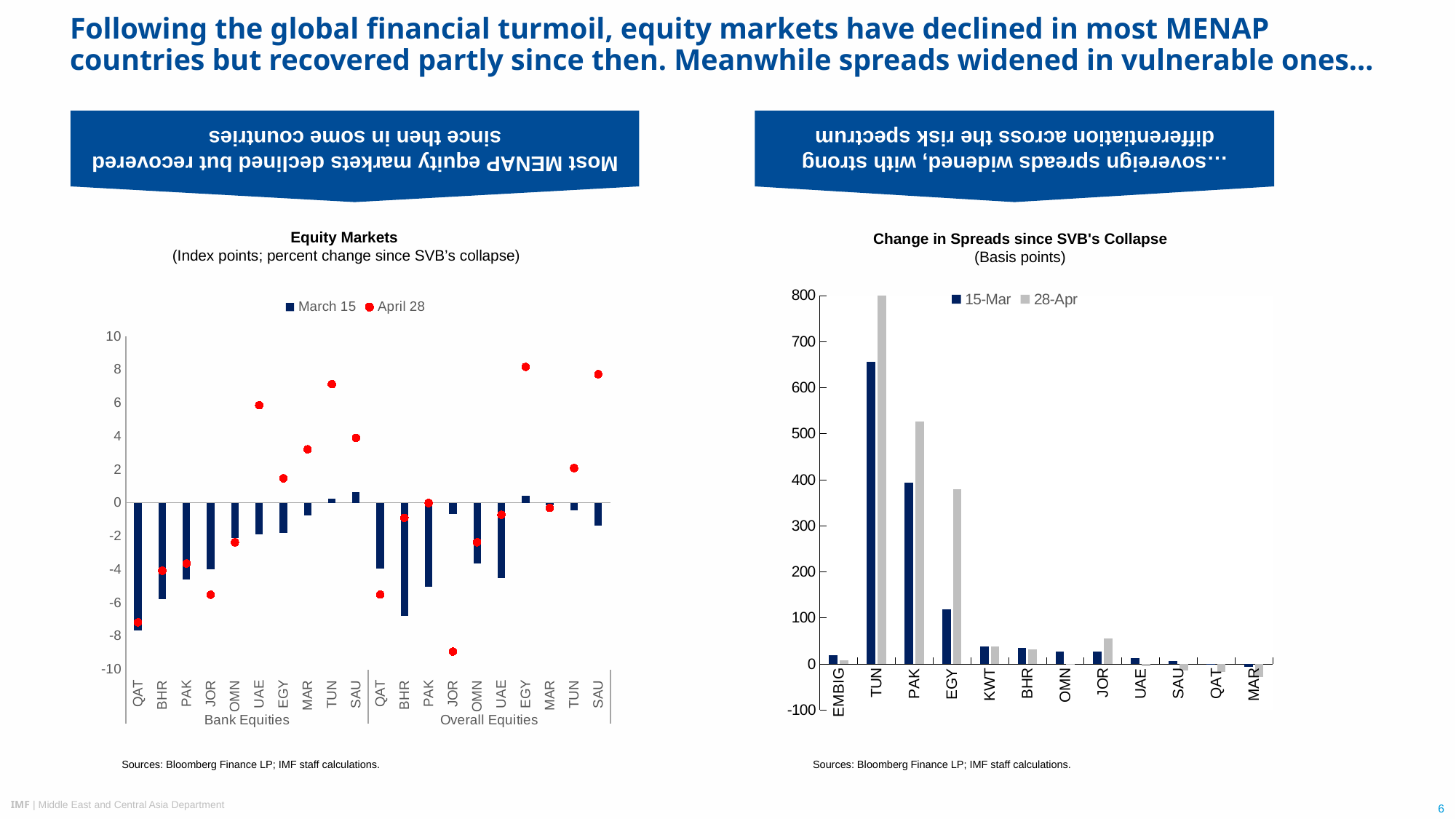
On the Change in Spreads since SVB's Collapse chart, which is larger for EGY, the 15-Mar value or the 28-Apr value? 28-Apr On the Equity Markets chart, which country in the Overall Equities group has the highest April 28 value? EGY On the Change in Spreads since SVB's Collapse chart, how many categories are shown on the x axis? 12 On the Equity Markets chart, is the March 15 value for QAT in the Bank Equities group greater or less than -6? less On the Equity Markets chart, which country in the Overall Equities group has the lowest April 28 value? JOR On the Equity Markets chart, how many countries are shown in the Bank Equities group? 10 On the Equity Markets chart, which country in the Bank Equities group has the lowest March 15 value? QAT On the Change in Spreads since SVB's Collapse chart, which country has the highest 28-Apr value? TUN On the Change in Spreads since SVB's Collapse chart, is the 15-Mar value for TUN greater or less than 600? greater On the Equity Markets chart, what kind of chart is it? combination bar and line chart (bars with dot markers) On the Change in Spreads since SVB's Collapse chart, is the 28-Apr value for PAK greater or less than 500? greater On the Equity Markets chart, how many series does the legend list? 2